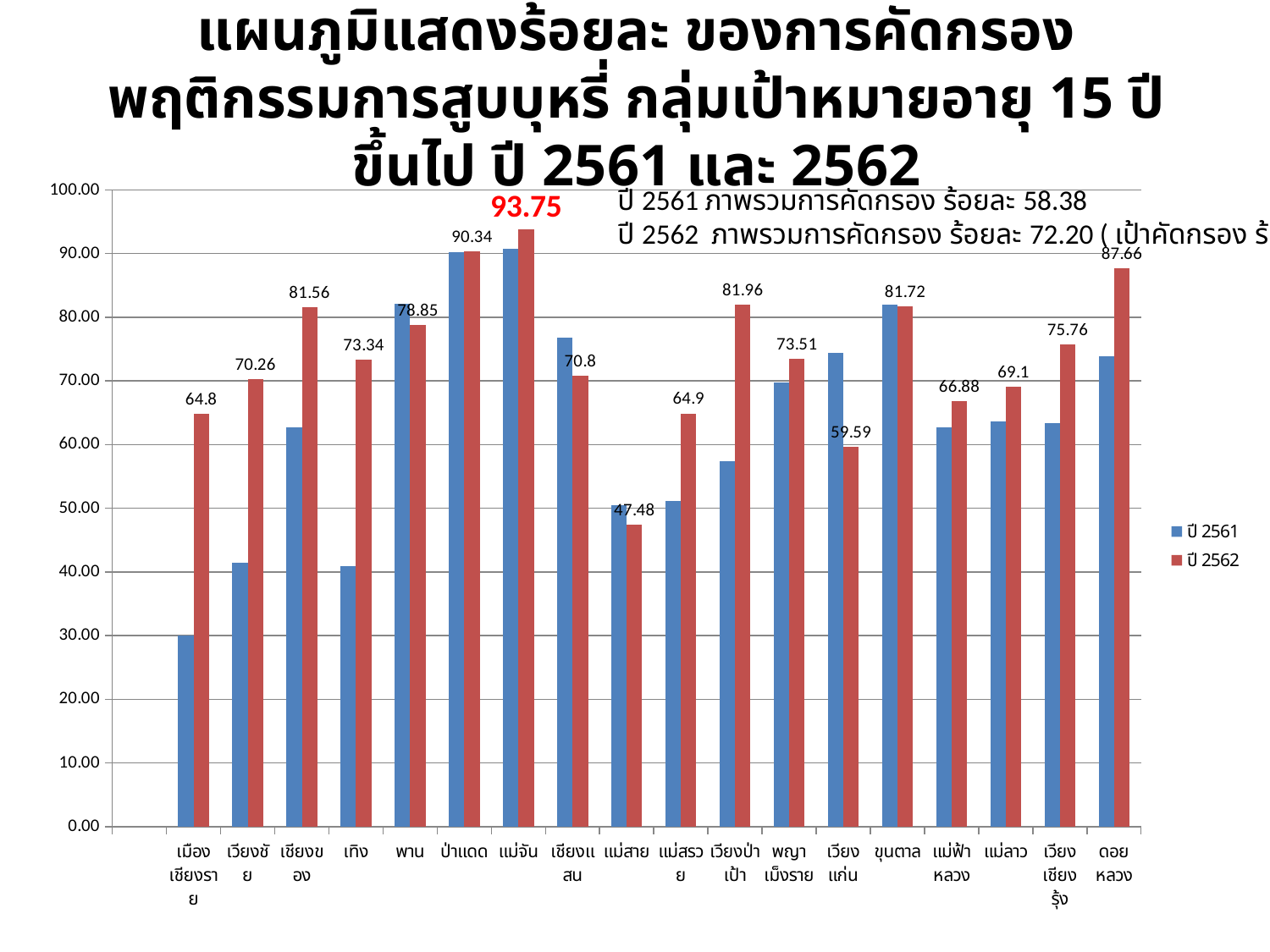
Which category has the lowest ปี 2562 value? แม่สาย What is the ปี 2562 value for ดอยหลวง? 87.66 How many categories are shown on the x axis? 18 For แม่สาย, which series is larger, ปี 2561 or ปี 2562? ปี 2561 How many series does the legend list? 2 What is the difference between the ปี 2562 values for แม่จัน and ป่าแดด? 3.41 Which category has the highest ปี 2562 value? แม่จัน Is the ปี 2561 value for เมืองเชียงราย greater or less than 40.00? less What is the ปี 2562 value for เวียงแก่น? 59.59 What is the difference between the ปี 2562 values for ขุนตาล and เวียงแก่น? 22.13 Which has the larger ปี 2562 value, เวียงป่าเป้า or พญาเม็งราย? เวียงป่าเป้า What is the ปี 2562 value for เชียงของ? 81.56